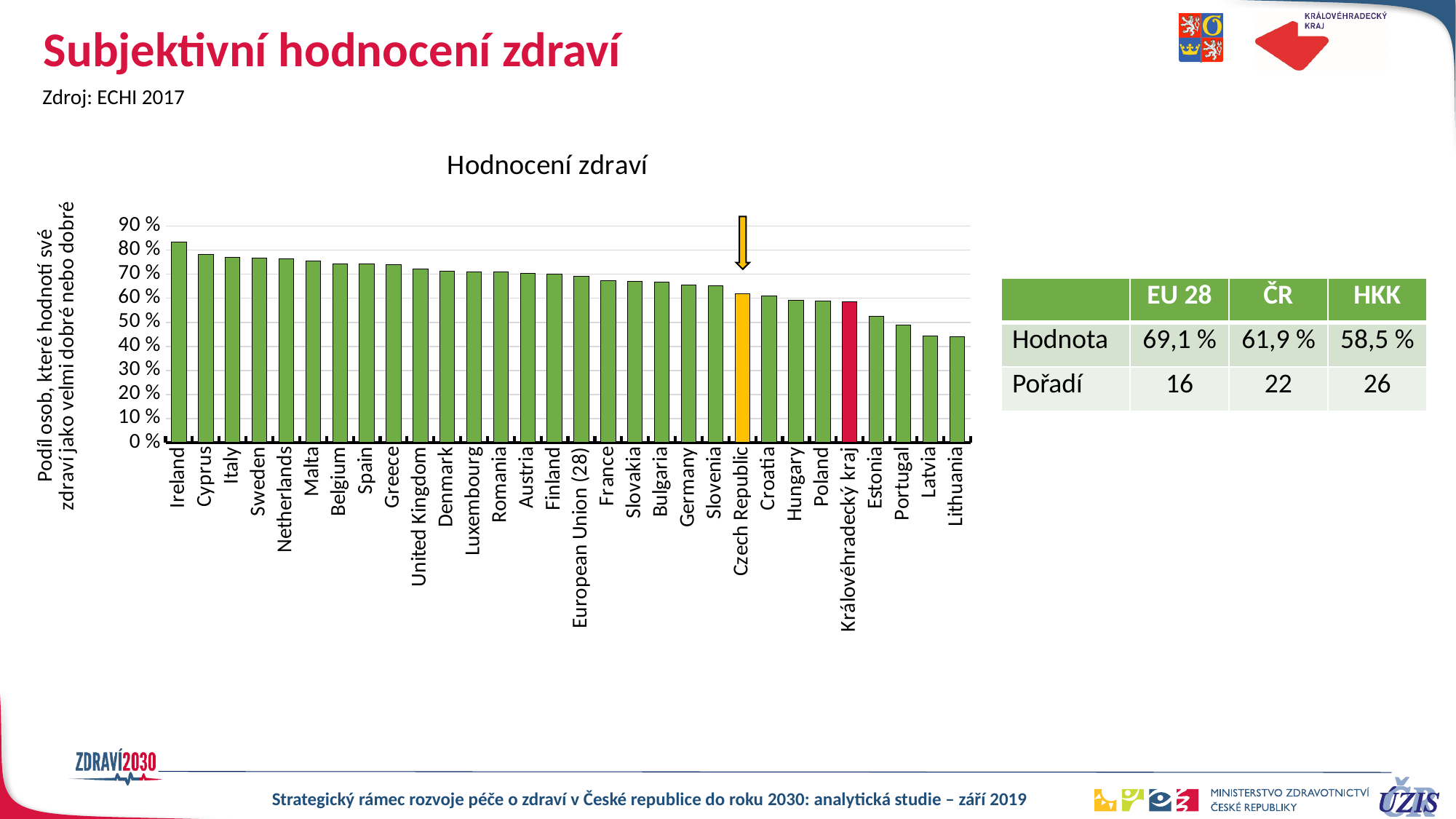
What is the value for European Union (28)? 69,1 % Is the value for Ireland greater or less than 70 %? greater What is the value for Czech Republic? 61,9 % Which category has the highest value in the chart? Ireland How many categories (bars) are plotted in the chart? 30 What type of chart is shown on the slide? bar chart Which is larger, the value for Cyprus or the value for Estonia? Cyprus What is the difference between the values for European Union (28) and Czech Republic? 7,2 % Do the values rise or fall from left to right along the x axis? fall Is the value for Estonia greater or less than 60 %? less What is the value for Královéhradecký kraj? 58,5 % What is the difference between the values for Czech Republic and Královéhradecký kraj? 3,4 %